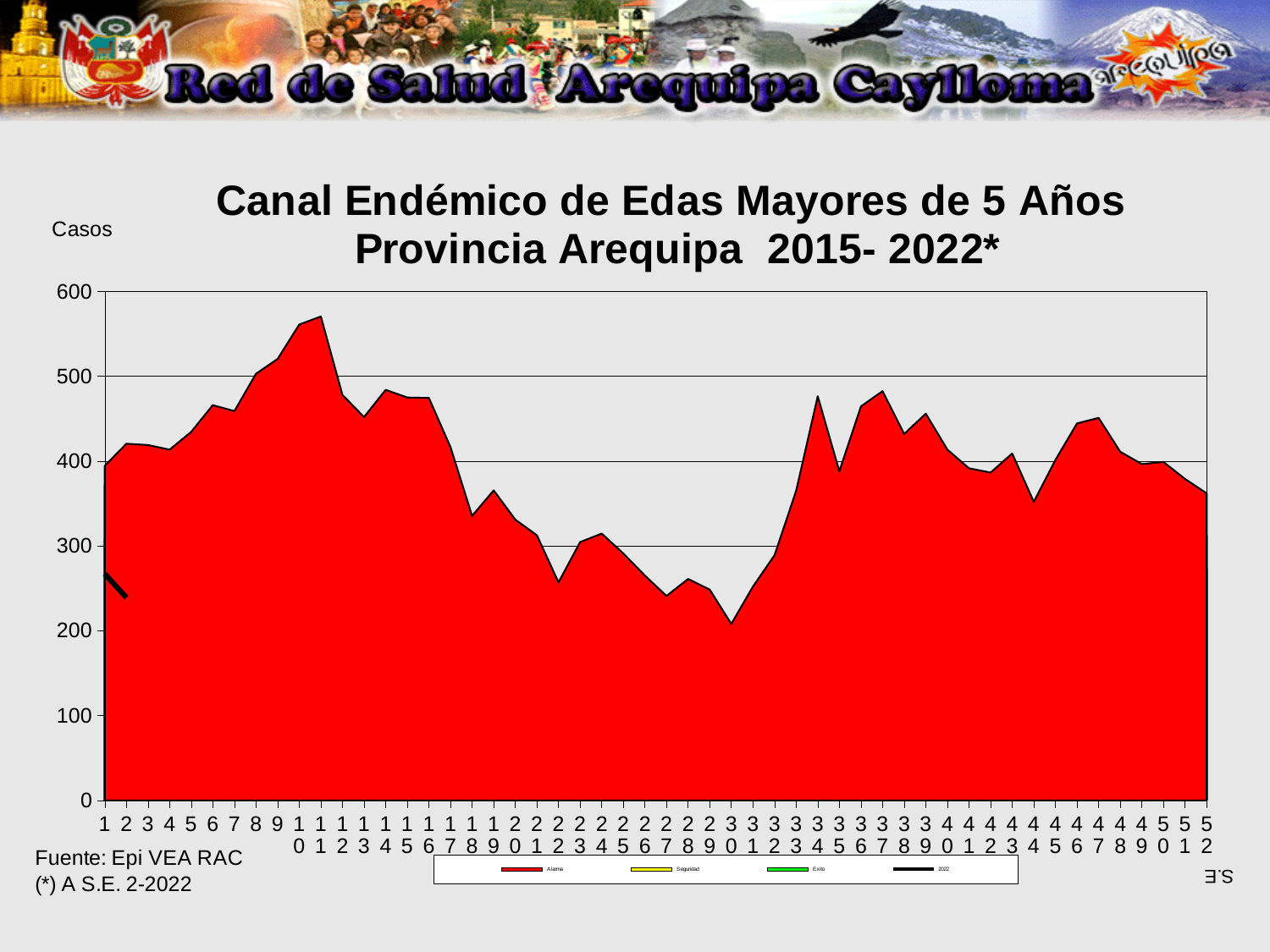
What is the title of the chart? Canal Endémico de Edas Mayores de 5 Años Provincia Arequipa 2015- 2022* Is the value of the red area at week 34 greater or less than 400? greater What kind of chart is shown on the slide? Area chart Is the value of the red area at week 11 greater or less than 500? greater At which week does the red area reach its lowest value? 30 How many epidemiological weeks are shown along the x axis? 52 Which week has a larger value in the red area, week 11 or week 30? Week 11 Is the value of the red area at week 30 greater or less than 300? less At which week does the red area reach its highest value? 11 How many entries does the chart legend list? 4 Between week 11 and week 30, do the values of the red area generally rise or fall? Fall What label is shown on the vertical axis of the chart? Casos